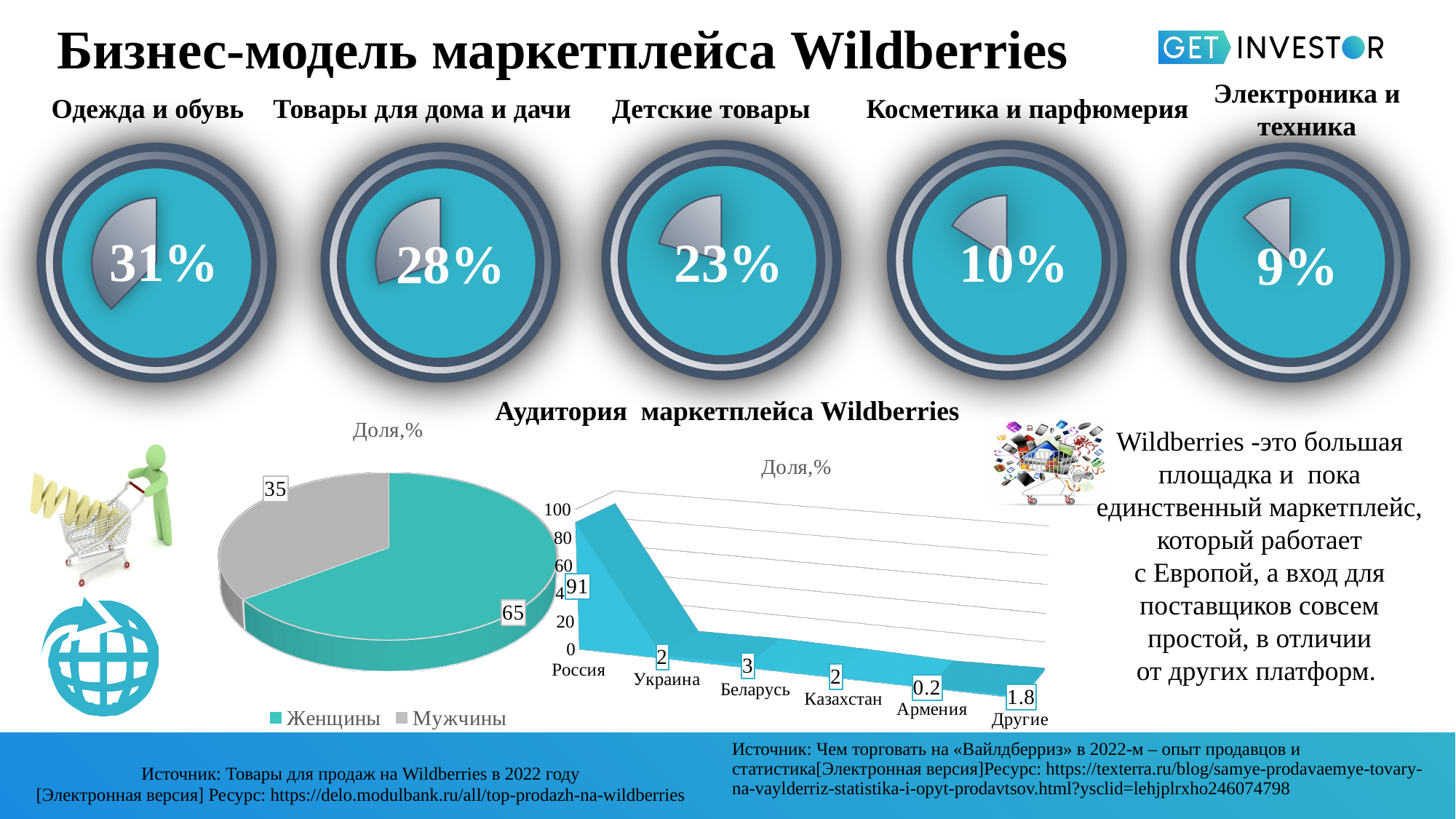
In the top row of circular charts, what is the difference between the shares for Одежда и обувь and Детские товары? 8% How many categories are plotted on the x axis of the area chart at the lower right? 6 In the top row of circular charts, what share is shown for Электроника и техника? 9% Among the five circular charts in the top row, which category has the lowest share? Электроника и техника In the area chart at the lower right, what value is shown for Армения? 0.2 In the pie chart at the lower left, what is the difference between the values for Женщины and Мужчины? 30 In the top row of circular charts, what share is shown for Одежда и обувь? 31% In the area chart at the lower right, which has the larger value, Беларусь or Украина? Беларусь In the area chart at the lower right, what value is shown for Россия? 91 How many entries does the legend of the pie chart at the lower left list? 2 In the pie chart at the lower left, what value is shown for Женщины? 65 Among the five circular charts in the top row, which category has the highest share? Одежда и обувь